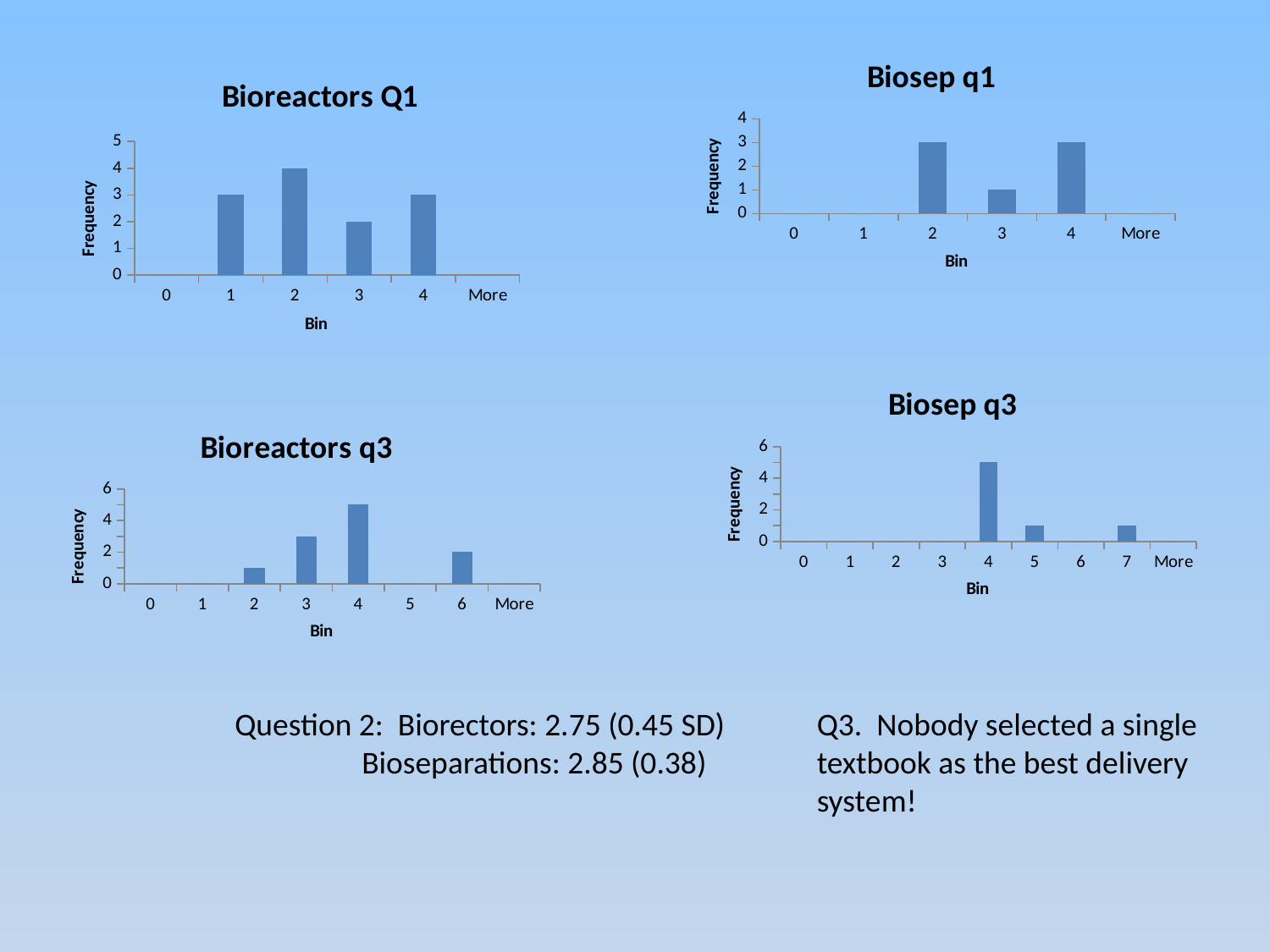
In the Bioreactors Q1 chart, what is the difference between the frequencies for bin 2 and bin 3? 2 What kind of chart is the Biosep q3 chart? bar chart In the Bioreactors Q1 chart, what is the frequency for bin 2? 4 In the Bioreactors q3 chart, what is the frequency for bin 6? 2 In the Biosep q3 chart, is the frequency for bin 5 greater or less than 2? less In the Biosep q1 chart, what is the frequency for bin 4? 3 In the Bioreactors Q1 chart, which bin has the highest frequency? 2 In the Bioreactors Q1 chart, how many bins are shown on the x axis? 6 In the Bioreactors q3 chart, which bin has the highest frequency? 4 In the Bioreactors q3 chart, is the frequency for bin 4 greater or less than 4? greater In the Biosep q1 chart, what is the frequency for bin 3? 1 In the Biosep q1 chart, is the frequency for bin 2 larger or smaller than the frequency for bin 3? larger